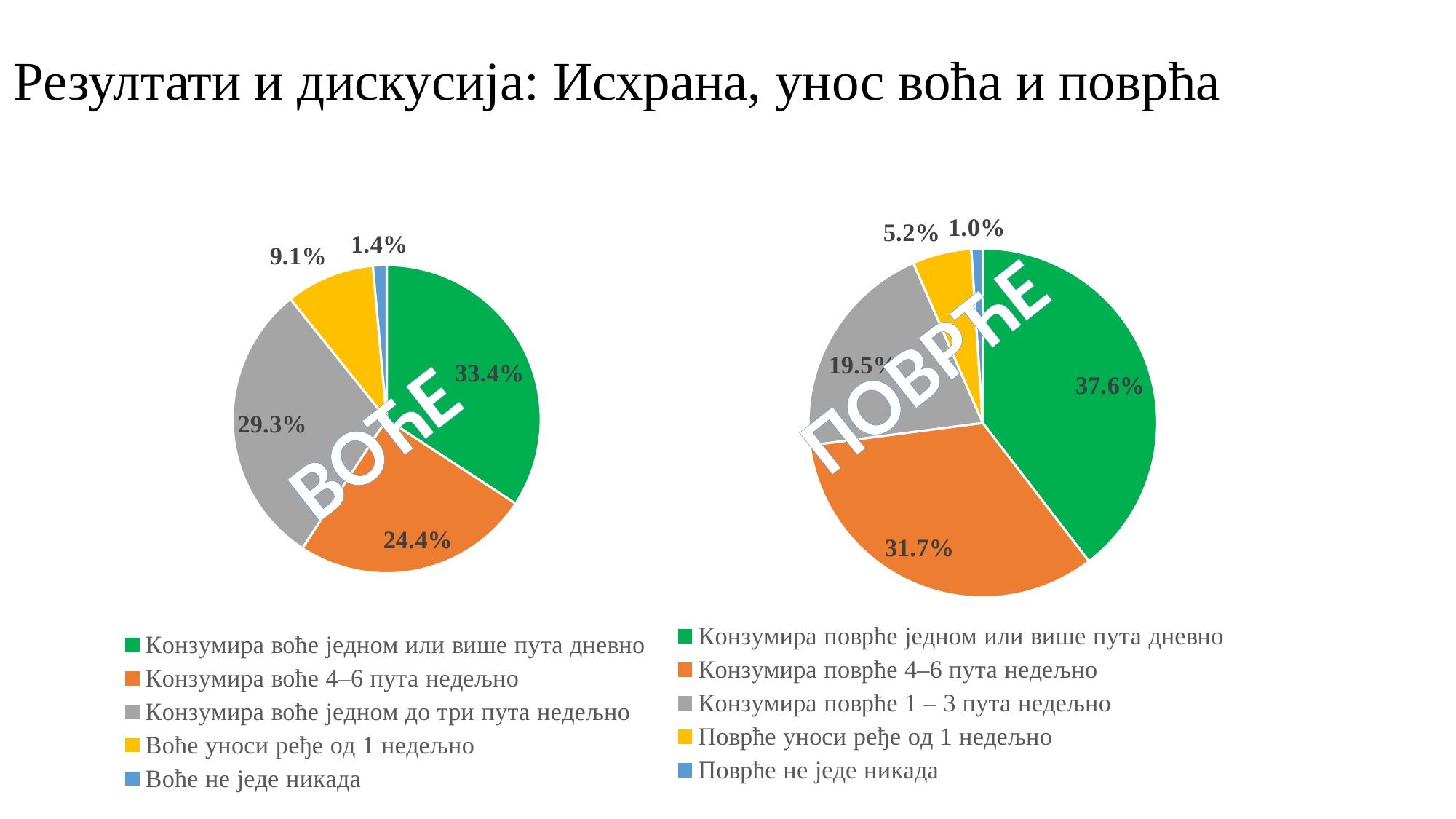
In the right pie chart (ПОВРЋЕ), what share of respondents consume vegetables 4–6 times per week? 31.7% What colour is the slice for consuming vegetables once or more per day in the right pie chart? Green In the right pie chart (ПОВРЋЕ), which category has the largest share? Конзумира поврће једном или више пута дневно In the left pie chart (ВОЋЕ), which category has the smallest share? Воће не једе никада Which is larger: the share consuming fruit 1–3 times per week in the left chart, or the share consuming vegetables 1–3 times per week in the right chart? Fruit (29.3%) In the left pie chart (ВОЋЕ), what percentage never eats fruit? 1.4% In the left pie chart (ВОЋЕ), what is the difference between the share consuming fruit once or more daily and the share consuming fruit 4–6 times per week? 9.0% How many slices does the left pie chart (ВОЋЕ) have? 5 In the left pie chart (ВОЋЕ), what share of respondents consume fruit once or more per day? 33.4% What type of chart is used on this slide? Pie chart In the right pie chart (ПОВРЋЕ), what percentage eats vegetables less than once a week? 5.2% In the right pie chart (ПОВРЋЕ), what is the difference between the share consuming vegetables 1–3 times per week and the share consuming them less than once a week? 14.3%